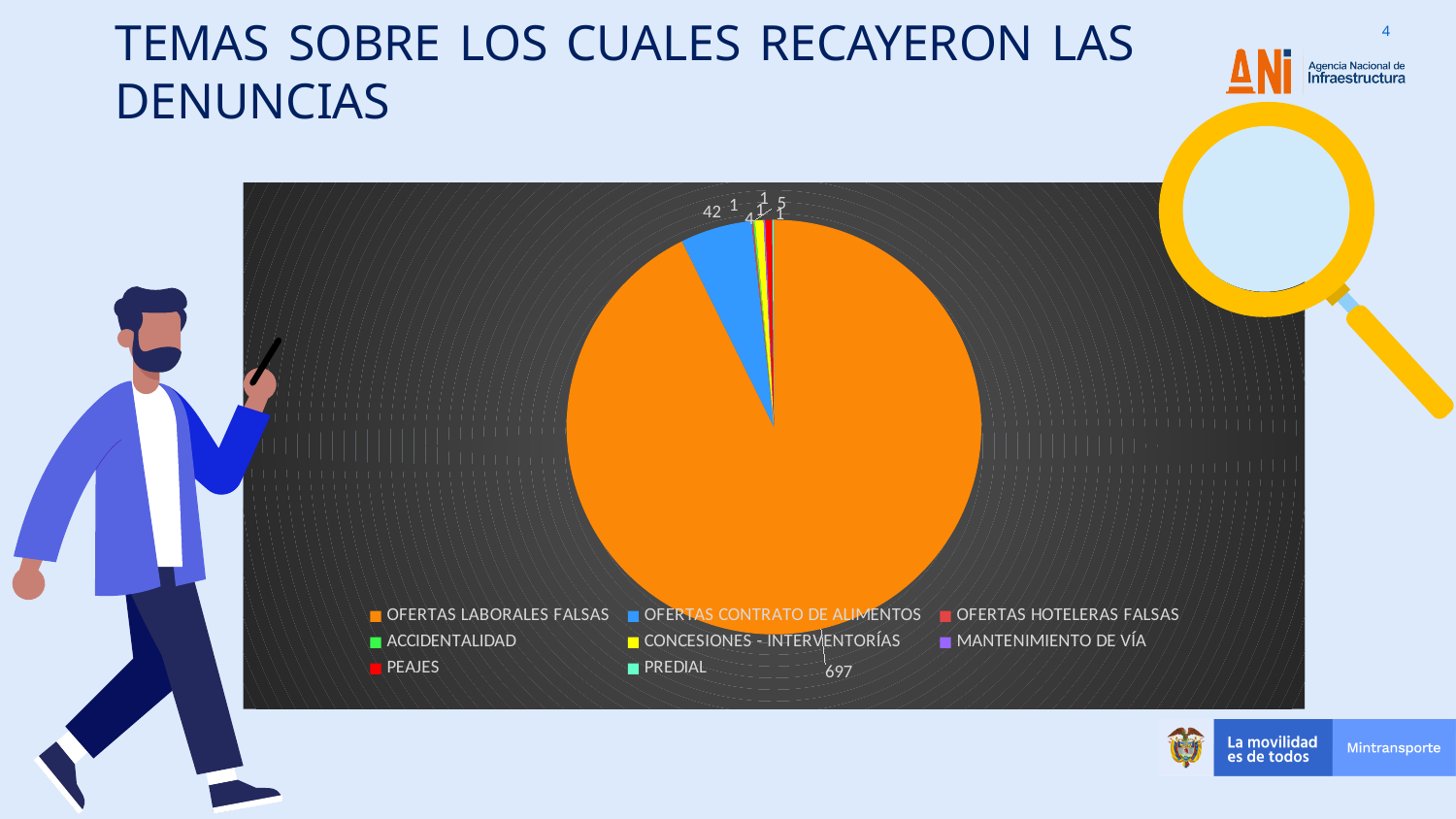
What kind of chart is shown on the slide? Pie chart How many categories does the legend of the pie chart list? 8 What is the difference between the values for OFERTAS LABORALES FALSAS and OFERTAS CONTRATO DE ALIMENTOS? 655 What is the title of the slide containing the pie chart? TEMAS SOBRE LOS CUALES RECAYERON LAS DENUNCIAS What is the value for OFERTAS LABORALES FALSAS in the pie chart? 697 What colour is the slice for OFERTAS LABORALES FALSAS? Orange Which is larger, OFERTAS LABORALES FALSAS or OFERTAS CONTRATO DE ALIMENTOS? OFERTAS LABORALES FALSAS What is the value for OFERTAS CONTRATO DE ALIMENTOS in the pie chart? 42 Which category has the largest slice in the pie chart? OFERTAS LABORALES FALSAS